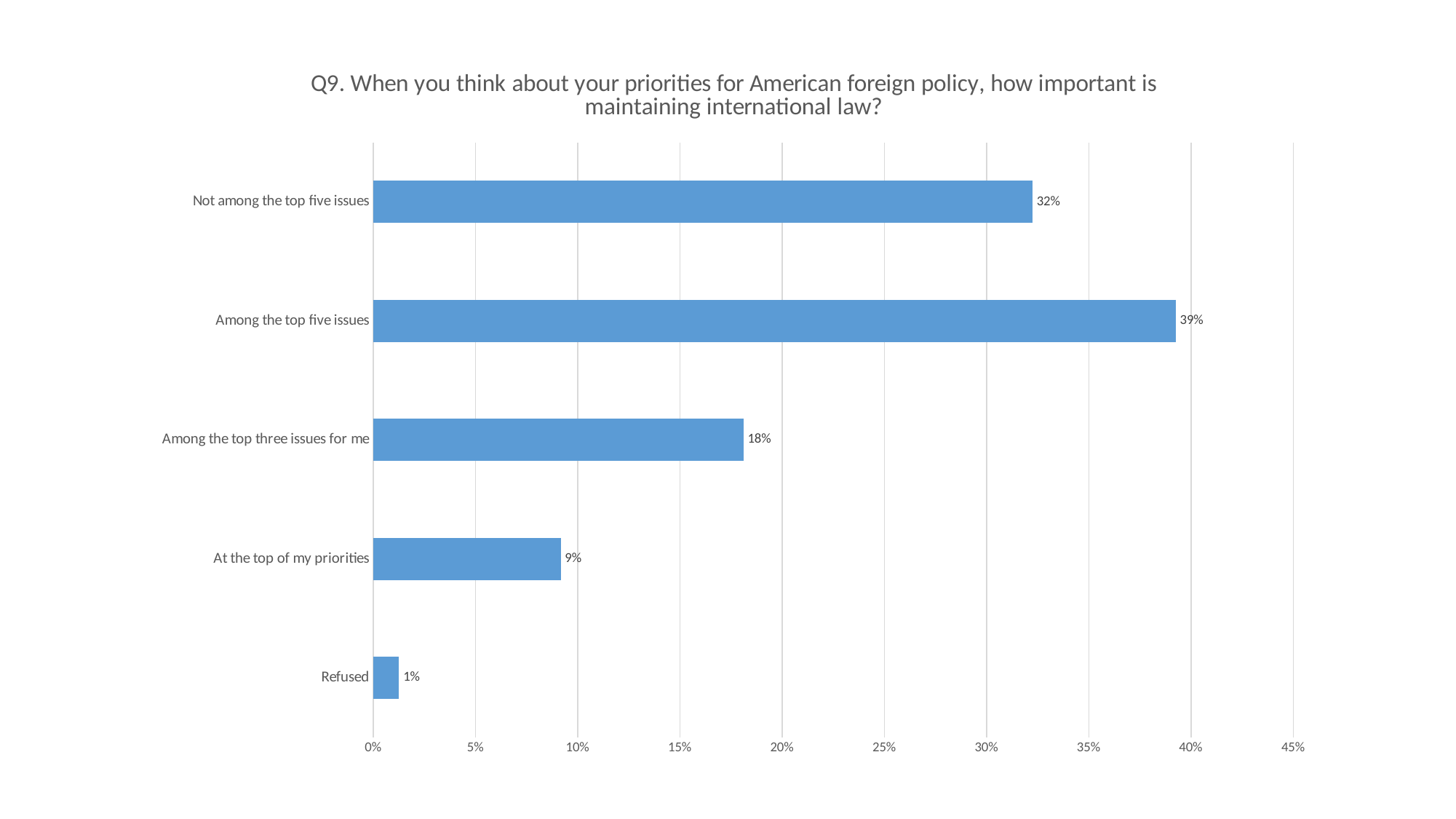
Is the value for "Not among the top five issues" greater or less than 30%? greater What percentage is shown for "Refused"? 1% Which category has the highest value? Among the top five issues Which is larger: "Among the top three issues for me" or "At the top of my priorities"? Among the top three issues for me What is the difference between "Among the top three issues for me" and "At the top of my priorities"? 9% What is the difference between "Among the top five issues" and "Not among the top five issues"? 7% What kind of chart is shown on the slide? Bar chart What is the value for "At the top of my priorities"? 9% What is the highest value shown on the x axis? 45% How many categories are shown in the chart? 5 Which category has the lowest value? Refused What percentage of respondents said maintaining international law is "Among the top five issues"? 39%